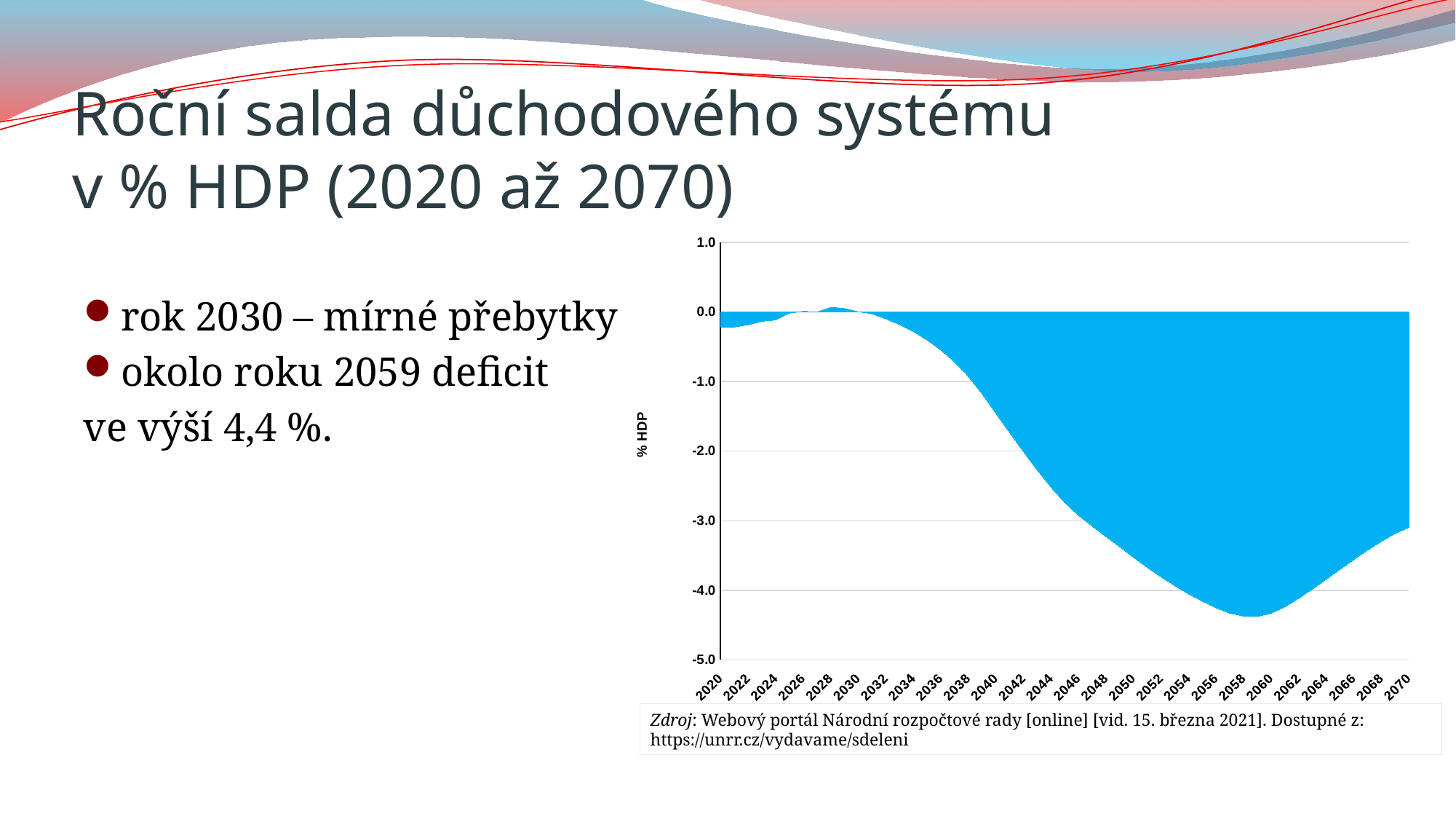
Is the value for 2050 greater or less than -3.0? less Is the value for 2044 greater or less than -2.0? less Which year has a higher value, 2040 or 2060? 2040 What is the label on the vertical axis of the chart? % HDP Is the value for 2066 greater or less than -4.0? greater How many year labels are shown on the horizontal axis of the chart? 26 Do the values rise or fall between 2030 and 2058? fall Around which year does the chart reach its lowest value? 2059 What is the first year shown on the horizontal axis of the chart? 2020 What kind of chart is shown on the slide? area chart